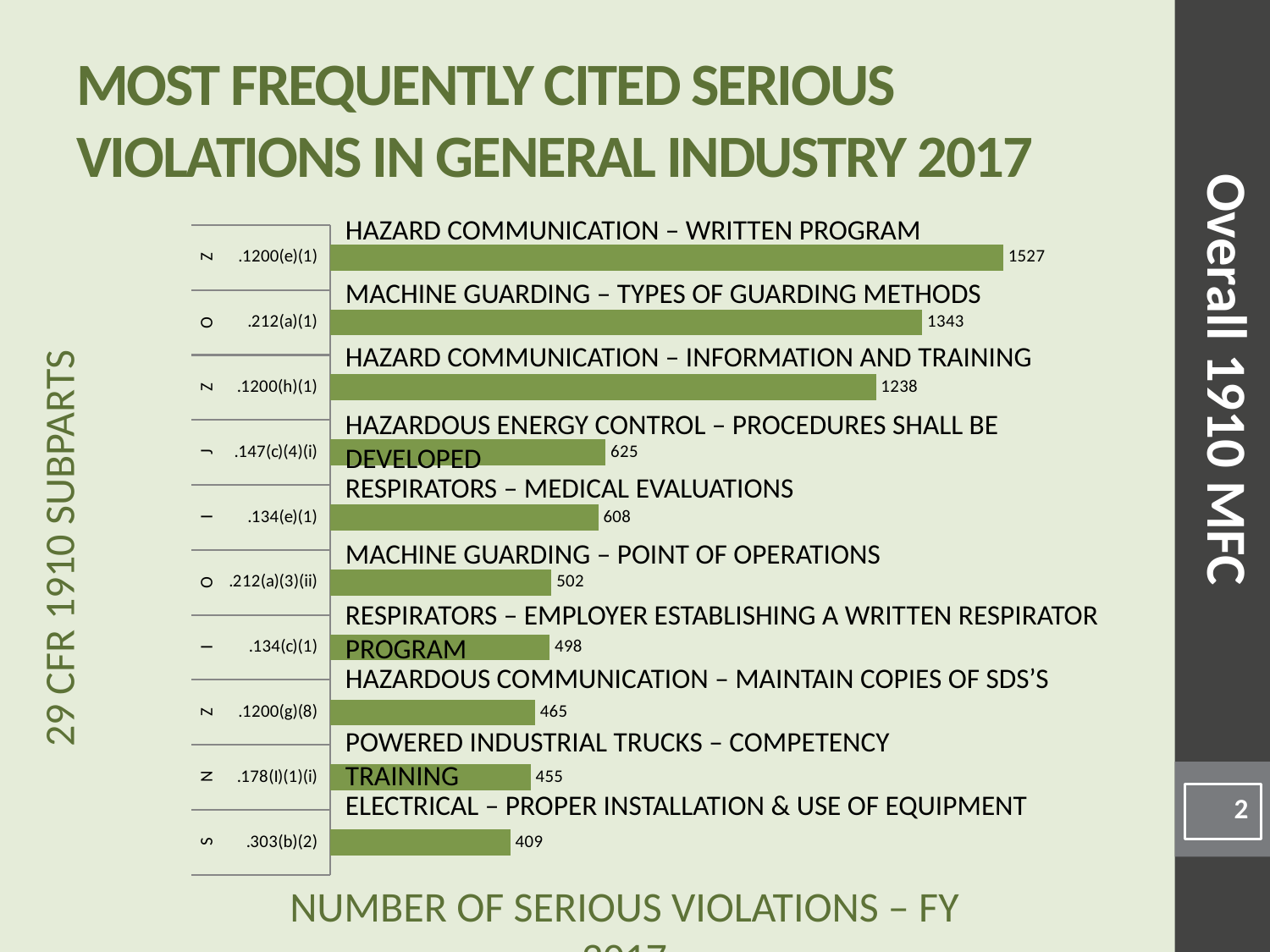
What is the title of the vertical axis of the chart? 29 CFR 1910 SUBPARTS What is the value for .303(b)(2), Electrical – Proper Installation & Use of Equipment? 409 What is the difference between the values for .147(c)(4)(i) and .134(e)(1)? 17 How many serious violations were cited for .1200(e)(1), Hazard Communication – Written Program? 1527 How many categories are plotted in the chart? 10 What kind of chart is shown on the slide? bar chart What is the value for .178(l)(1)(i), Powered Industrial Trucks – Competency Training? 455 Which is larger, the value for .1200(h)(1) or the value for .147(c)(4)(i)? .1200(h)(1) What is the value for .212(a)(1), Machine Guarding – Types of Guarding Methods? 1343 Which category has the highest number of serious violations? .1200(e)(1) Hazard Communication – Written Program Which category has the lowest number of serious violations? .303(b)(2) Electrical – Proper Installation & Use of Equipment What is the difference between the values for .1200(e)(1) and .212(a)(1)? 184